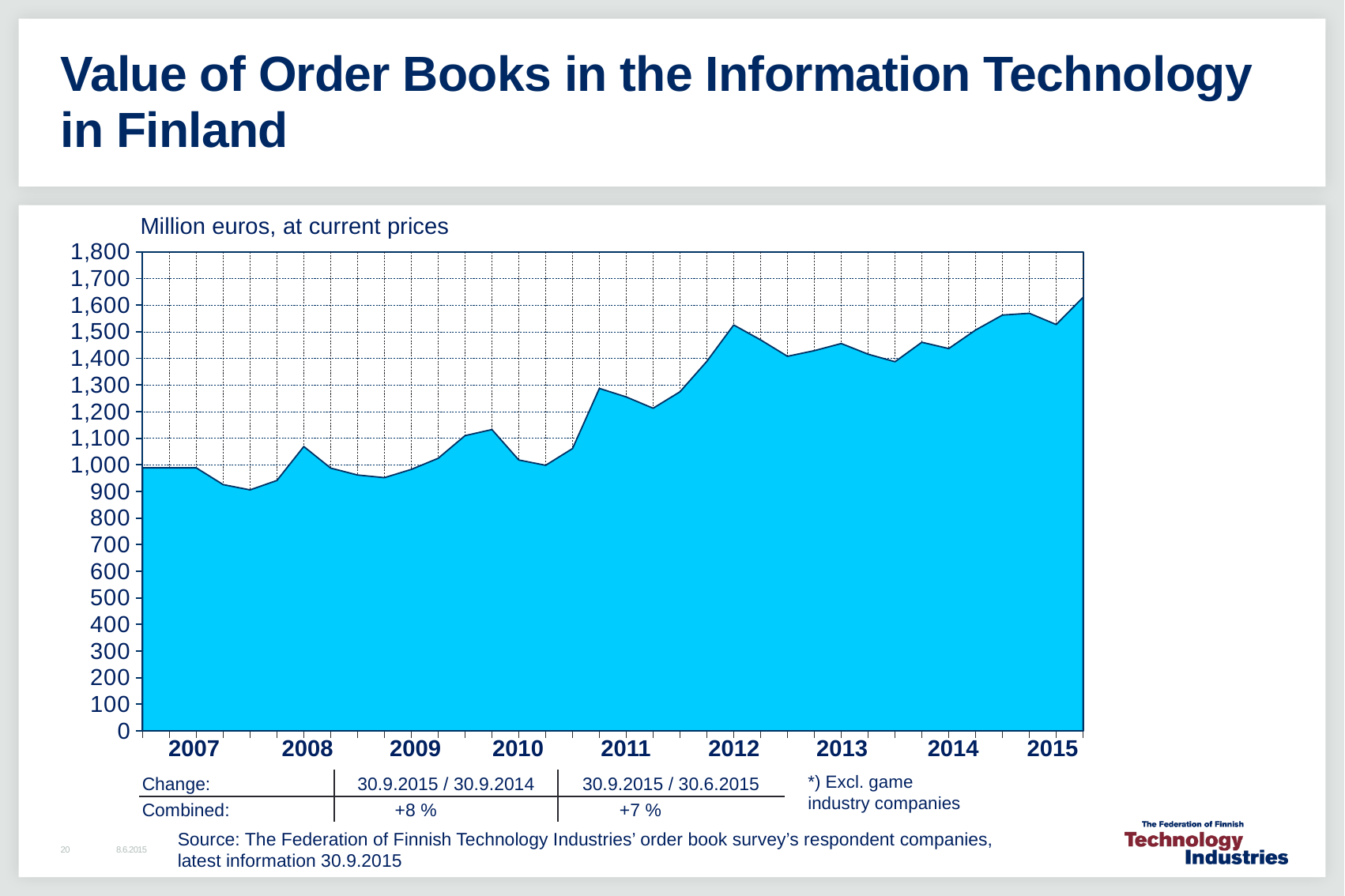
What is the title of the chart on the slide? Value of Order Books in the Information Technology in Finland Overall, do the values rise or fall from 2007 to 2015? rise Is the peak value reached in 2012 greater or less than 1,400? greater In which year does the series reach its highest value? 2015 What unit is stated above the y axis of the chart? Million euros, at current prices Is the value at the start of the series in 2007 greater or less than 1,100? less Is the lowest value of the series greater or less than 1,000? less What kind of chart is shown on the slide? Area chart How many year labels are shown on the x axis of the chart? 9 Which is higher: the value at the end of 2015 or the peak in 2012? End of 2015